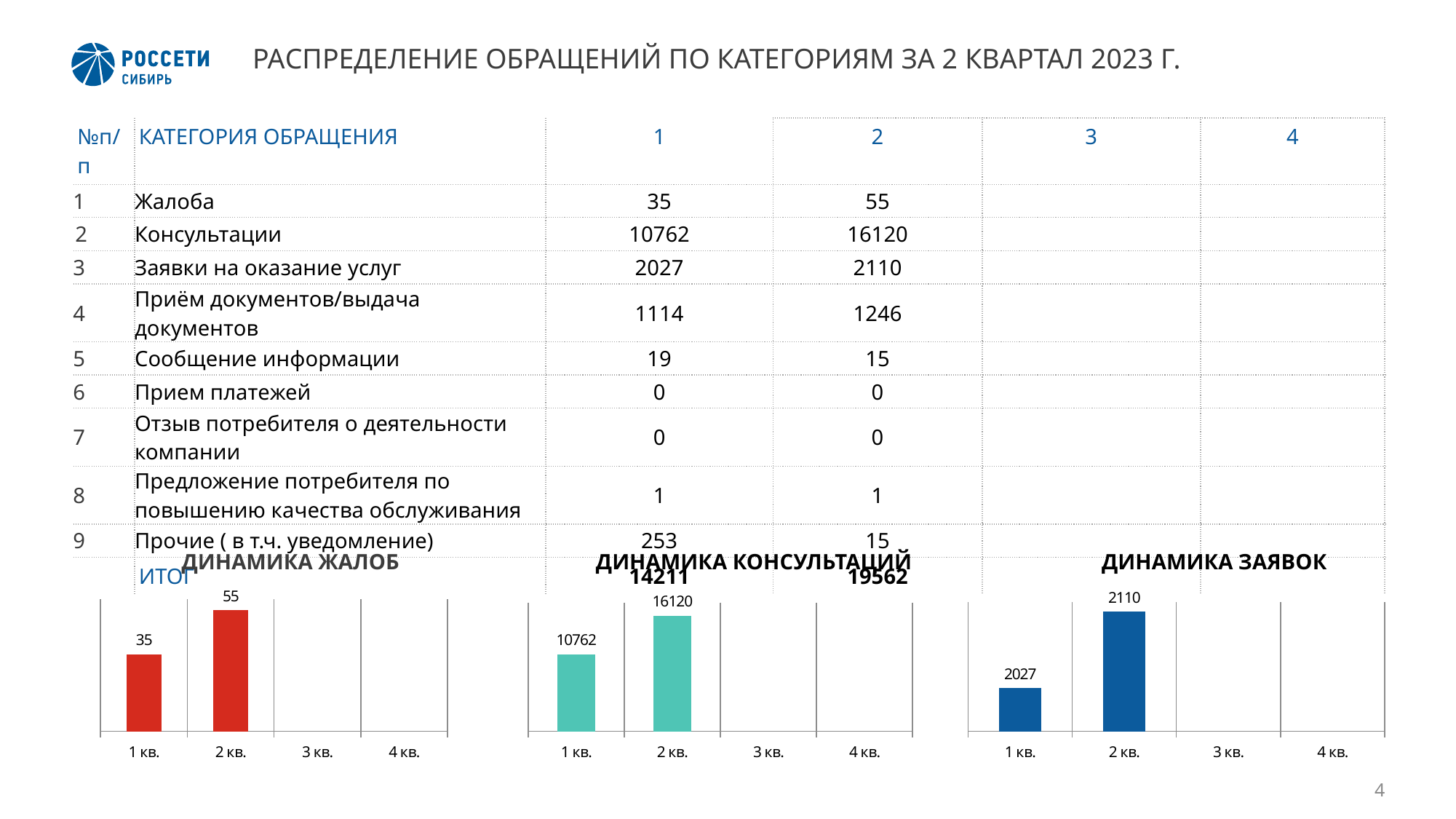
In the chart titled ДИНАМИКА ЖАЛОБ, which quarter has the higher value, 1 кв. or 2 кв.? 2 кв. In the chart titled ДИНАМИКА КОНСУЛЬТАЦИЙ, which quarter has the highest value? 2 кв. In the chart titled ДИНАМИКА ЖАЛОБ, what is the value for 1 кв.? 35 What kind of chart is the chart titled ДИНАМИКА ЗАЯВОК? bar chart In the chart titled ДИНАМИКА ЖАЛОБ, do the values rise or fall from 1 кв. to 2 кв.? rise In the chart titled ДИНАМИКА ЗАЯВОК, what is the value for 2 кв.? 2110 In the chart titled ДИНАМИКА КОНСУЛЬТАЦИЙ, what is the value for 1 кв.? 10762 In the chart titled ДИНАМИКА ЗАЯВОК, what is the difference between the values for 2 кв. and 1 кв.? 83 In the chart titled ДИНАМИКА КОНСУЛЬТАЦИЙ, what is the difference between the values for 2 кв. and 1 кв.? 5358 How many quarter categories are shown on the x axis of the chart titled ДИНАМИКА ЖАЛОБ? 4 In the chart titled ДИНАМИКА КОНСУЛЬТАЦИЙ, what is the value for 2 кв.? 16120 In the chart titled ДИНАМИКА ЖАЛОБ, what is the value for 2 кв.? 55